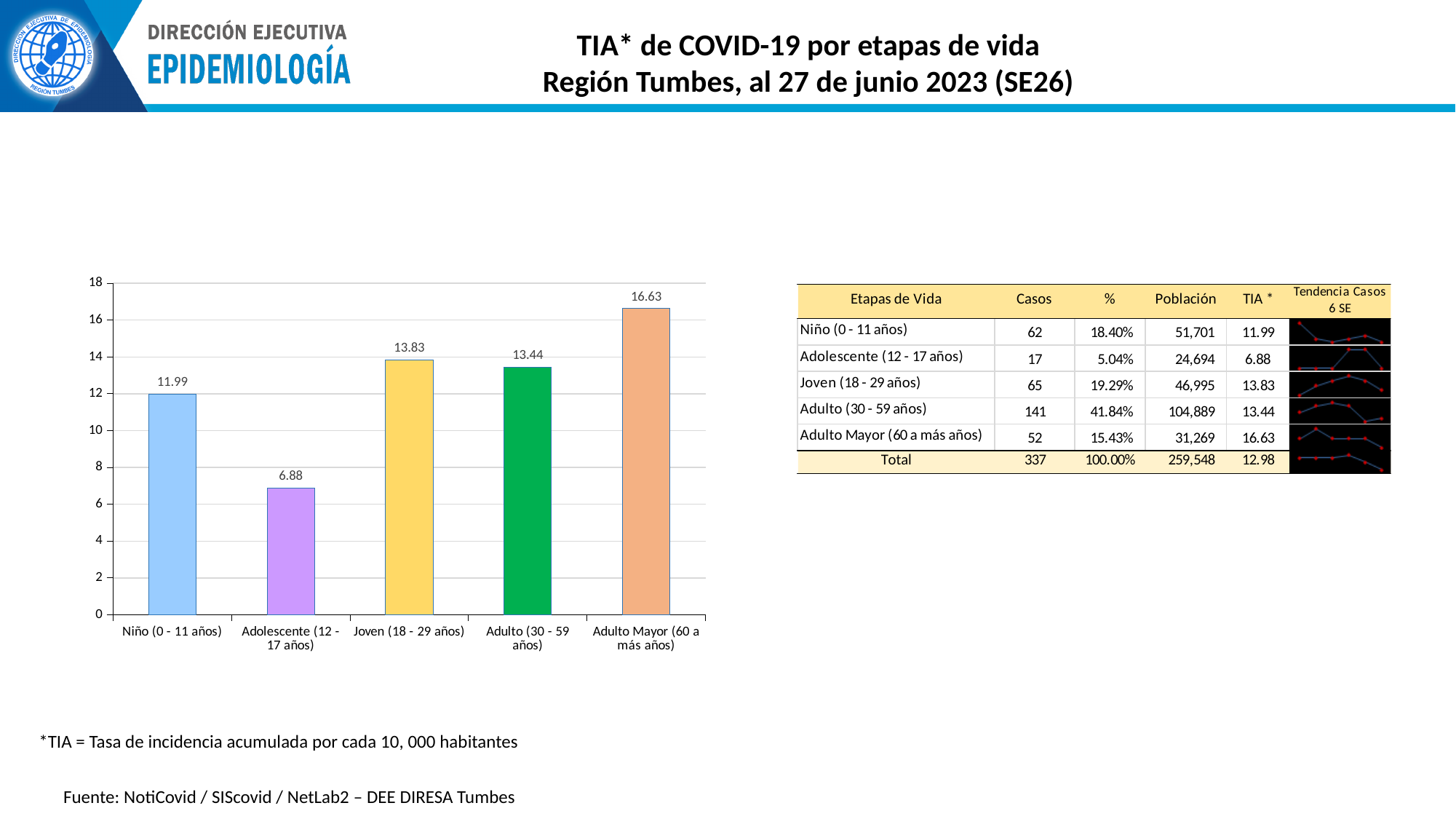
What colour is the bar for Adulto (30 - 59 años)? Green What is the difference between the TIA for Adulto Mayor (60 a más años) and Adolescente (12 - 17 años)? 9.75 What type of chart is used to show TIA by life stage? Bar chart What is the TIA value shown for Joven (18 - 29 años)? 13.83 Which life stage has the lowest TIA in the bar chart? Adolescente (12 - 17 años) Which has a higher TIA, Joven (18 - 29 años) or Adulto (30 - 59 años)? Joven (18 - 29 años) What is the TIA value shown for Adolescente (12 - 17 años)? 6.88 Which life stage has the highest TIA in the bar chart? Adulto Mayor (60 a más años) What is the TIA value shown for Adulto Mayor (60 a más años)? 16.63 Is the TIA value for Niño (0 - 11 años) greater or less than 10? greater How many life-stage categories are plotted in the bar chart? 5 What is the TIA value shown for Niño (0 - 11 años)? 11.99